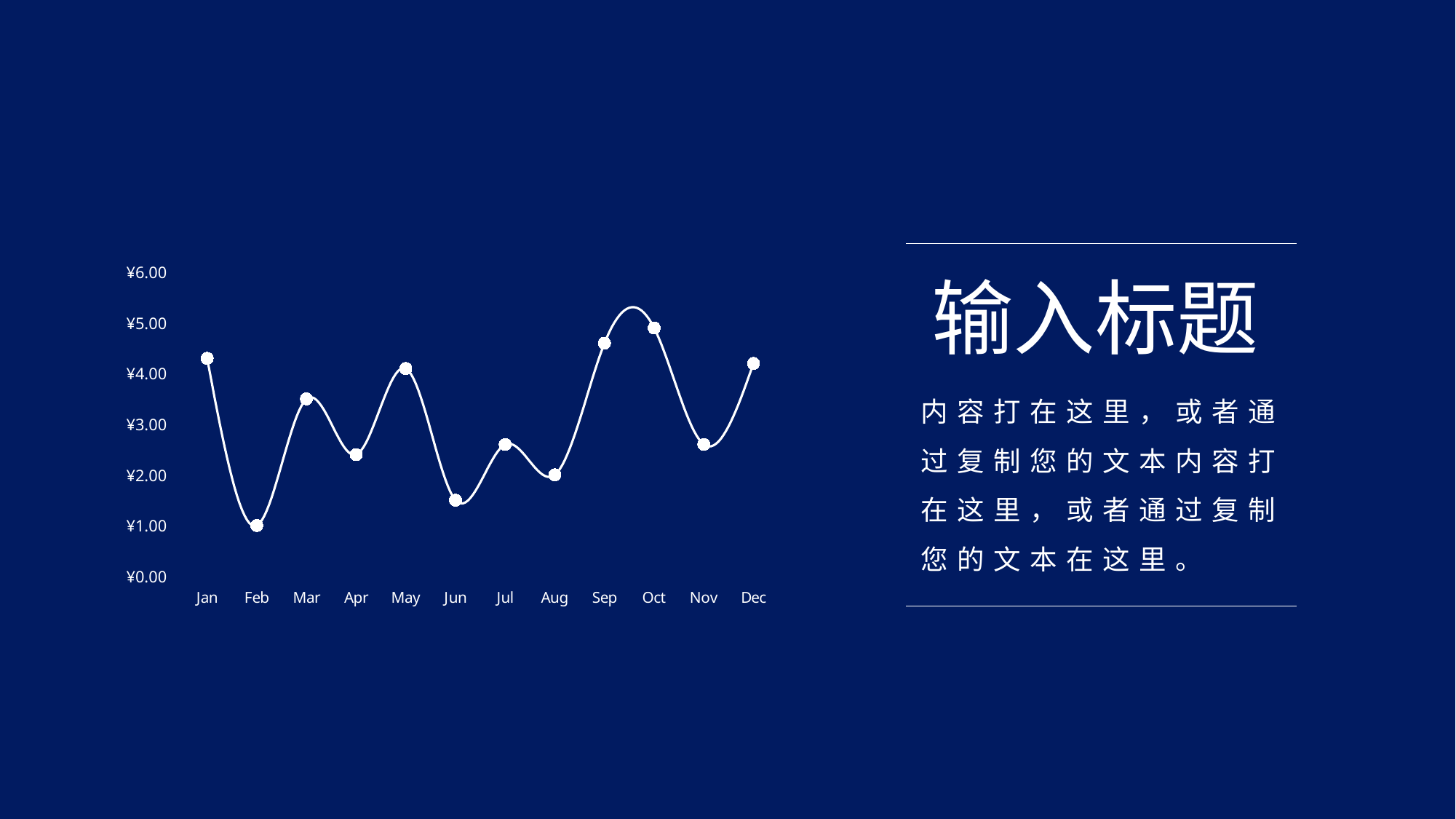
Is the value for Feb greater or less than ¥2.00? less Is the value for Jan greater or less than ¥4.00? greater Which month has the highest value in the chart? Oct Does the value rise or fall from Aug to Oct? rise Which month has the lowest value in the chart? Feb How many months are plotted along the x axis of the chart? 12 Is the value for Sep greater or less than ¥4.00? greater What kind of chart is shown on the slide? line chart Which is larger, the value for Mar or the value for Apr? Mar Which is larger, the value for May or the value for Jun? May